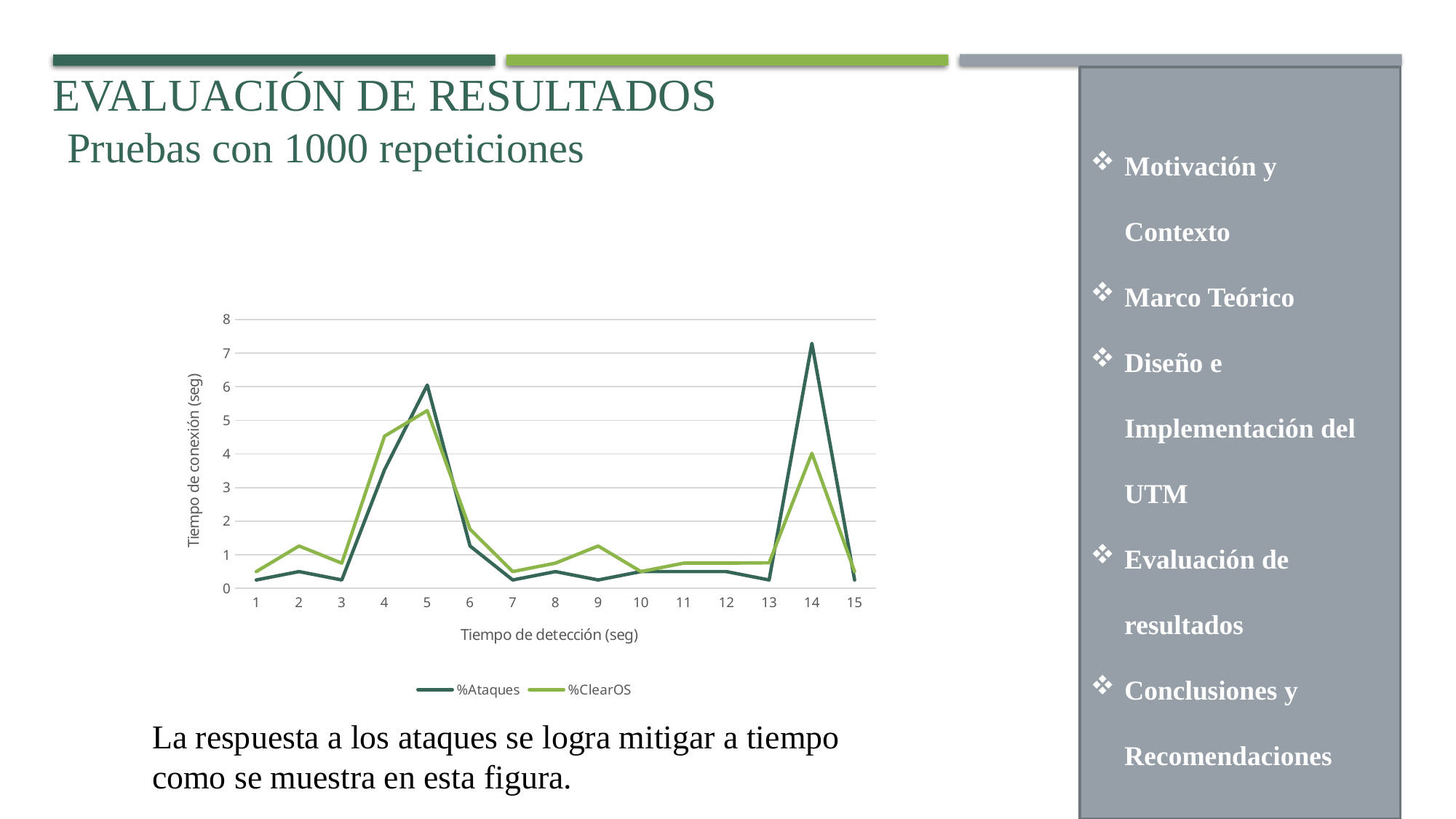
What kind of chart is shown on the slide? line chart Is the value of %Ataques at x = 5 greater or less than 5? greater How many series does the legend list? 2 At x = 14, which series has the larger value, %Ataques or %ClearOS? %Ataques At which x-axis value does the %ClearOS series reach its highest point? 5 Between x = 5 and x = 7, does the %Ataques series rise or fall? fall At which x-axis value does the %Ataques series reach its highest point? 14 Is the value of %ClearOS at x = 14 greater or less than 5? less At x = 4, which series has the larger value, %Ataques or %ClearOS? %ClearOS How many points along the x axis does each series have? 15 Is the value of %Ataques at x = 14 greater or less than 6? greater What is the title of the y axis? Tiempo de conexión (seg)